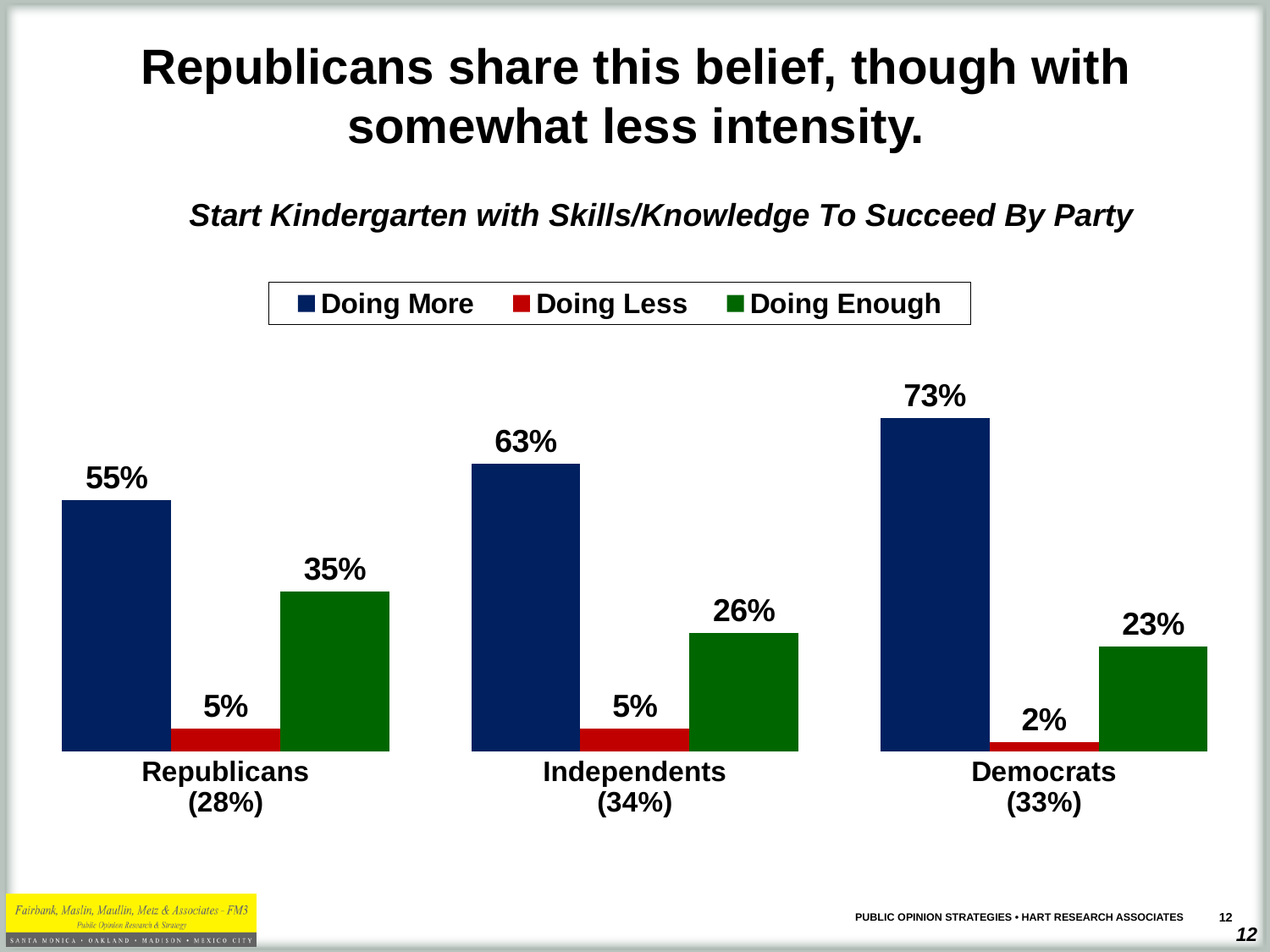
Which party group has the lowest "Doing Less" value? Democrats What percentage of Republicans say "Doing More"? 55% What is the "Doing Less" value for Independents? 5% How many series does the legend list? 3 Which party group has the highest "Doing More" value? Democrats How many party groups are shown on the x axis? 3 What kind of chart is shown on the slide? Bar chart Which colour represents "Doing Less" in the legend? Red Does the "Doing More" value rise or fall moving from Republicans to Independents to Democrats? Rise Which is larger: "Doing Enough" for Republicans or "Doing Enough" for Independents? Republicans What is the difference between the "Doing More" values for Democrats and Republicans? 18% What is the "Doing Enough" value for Democrats? 23%